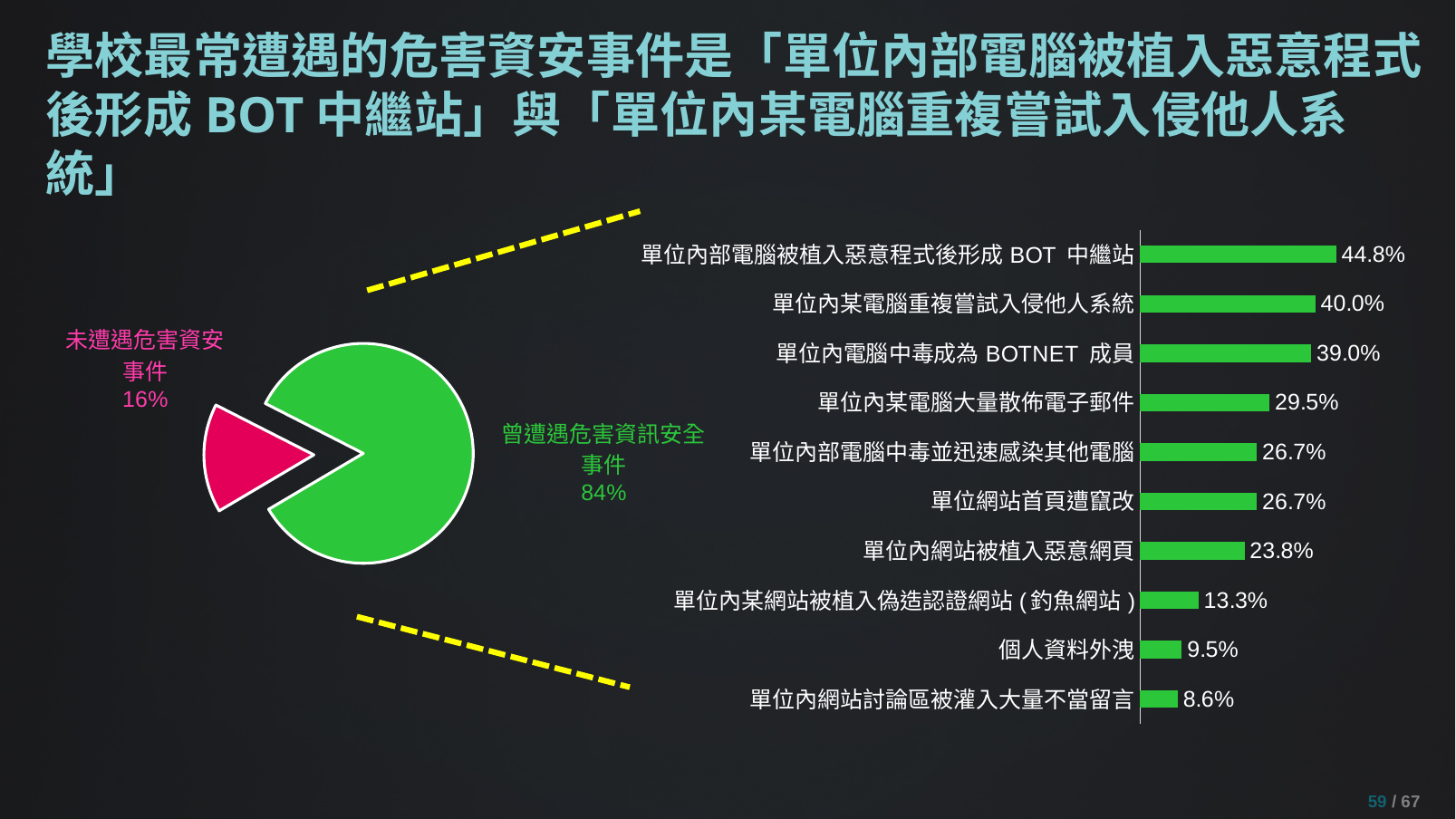
In the pie chart on the left, what share of schools have not encountered a harmful information security incident (未遭遇危害資安事件)? 16% How many slices does the pie chart on the left have? 2 In the bar chart on the right, what is the value for 個人資料外洩? 9.5% In the bar chart on the right, what is the value for 單位內某電腦大量散佈電子郵件? 29.5% In the bar chart on the right, which category has the lowest value? 單位內網站討論區被灌入大量不當留言 In the bar chart on the right, which is larger: the value for 單位內網站被植入惡意網頁 or the value for 單位內某網站被植入偽造認證網站 ( 釣魚網站 )? 單位內網站被植入惡意網頁 In the bar chart on the right, what is the difference between the values for 單位內某電腦重複嘗試入侵他人系統 and 單位內電腦中毒成為 BOTNET 成員? 1.0% What kind of chart is the chart on the right side of the slide? Bar chart In the pie chart on the left, what share of schools have encountered a harmful information security incident (曾遭遇危害資訊安全事件)? 84% How many categories are shown in the bar chart on the right? 10 In the bar chart on the right, which category has the highest value? 單位內部電腦被植入惡意程式後形成 BOT 中繼站 In the bar chart on the right, what is the value for 單位內部電腦被植入惡意程式後形成 BOT 中繼站? 44.8%